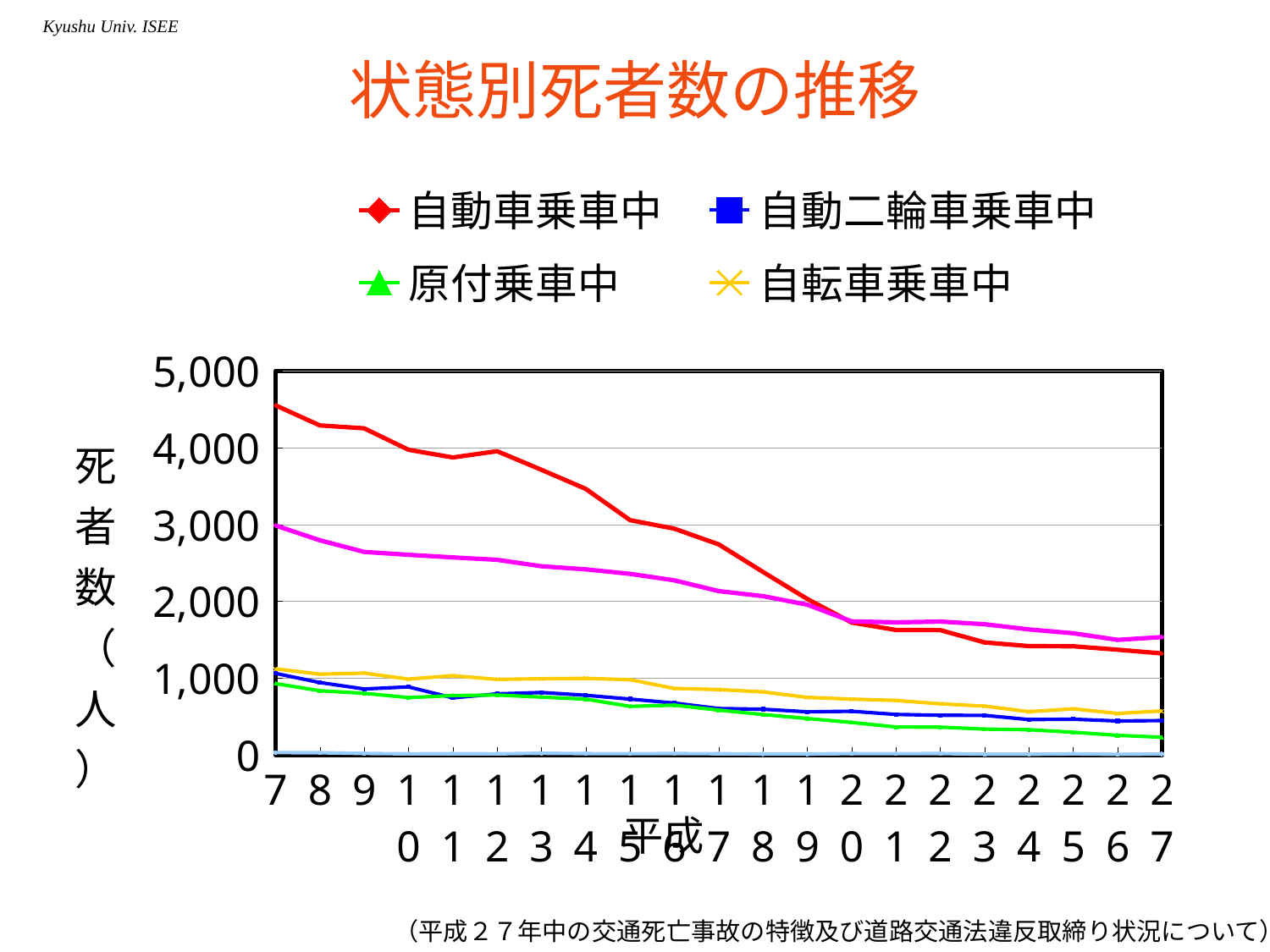
Is the value for 原付乗車中 in 平成27 greater or less than 1,000? less How many years (points) are shown along the x axis? 21 What is the label on the y axis? 死者数（人） Which legend series has the highest value in 平成7? 自動車乗車中 Is the value for 自転車乗車中 in 平成7 greater or less than 2,000? less Is the value for 自動車乗車中 in 平成7 greater or less than 4,000? greater How many series does the legend list? 4 In 平成7, which is larger: 自動車乗車中 or 原付乗車中? 自動車乗車中 What kind of chart is shown on the slide? line chart Which legend series has the lowest value in 平成27? 原付乗車中 Does the value for 自動車乗車中 rise or fall from 平成7 to 平成27? fall